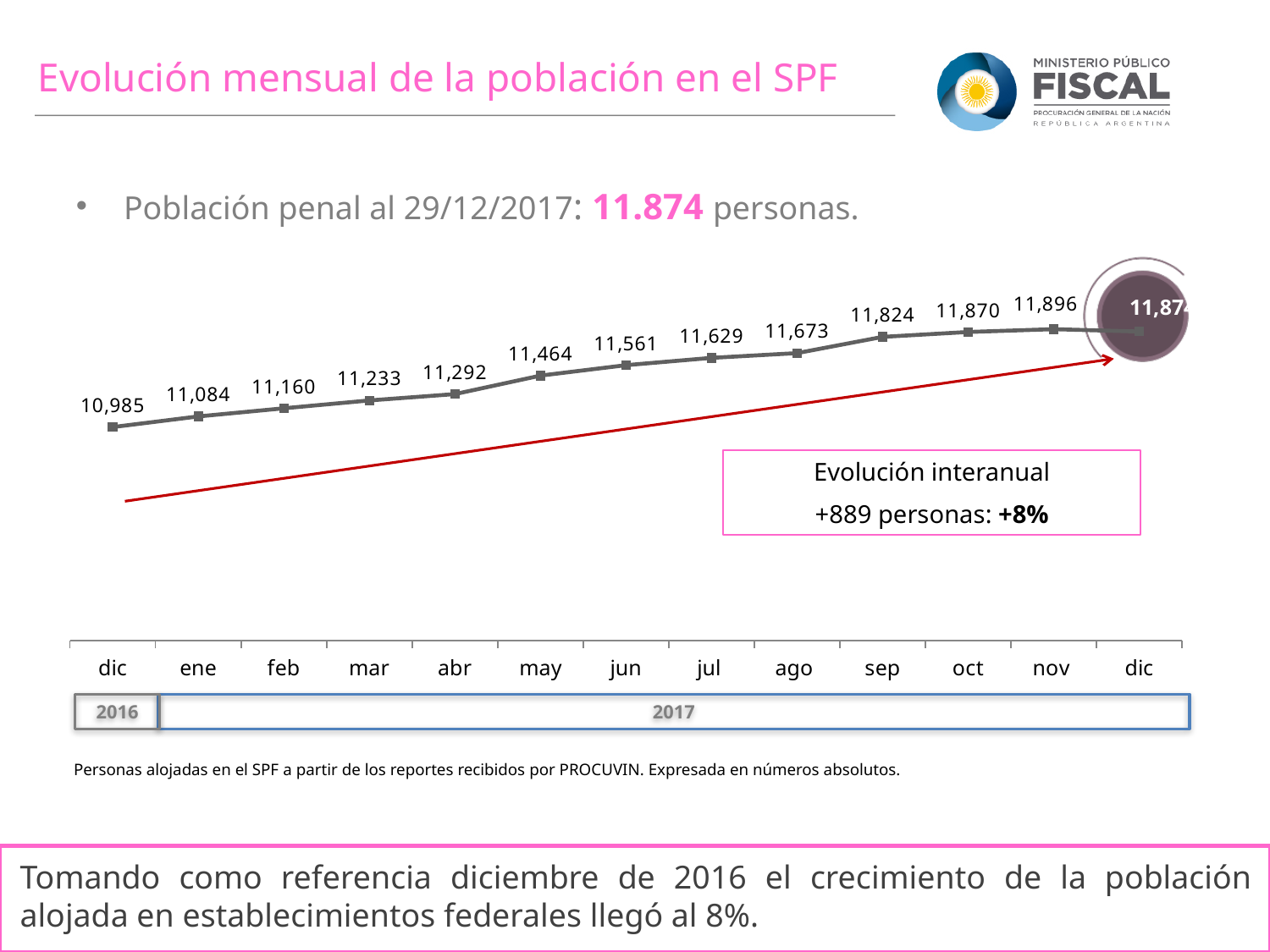
Which month has the highest value? nov 2017 What type of chart is shown on the slide? line chart How many data points are plotted on the chart? 13 What is the value for nov 2017? 11,896 What is the value for sep 2017? 11,824 Do the values generally rise or fall from dic 2016 to nov 2017? rise Which is larger, the value for mar 2017 or the value for abr 2017? abr 2017 What is the difference between the values for jun 2017 and may 2017? 97 What is the value for dic 2016? 10,985 What is the value for may 2017? 11,464 Which month has the lowest value? dic 2016 What is the difference between the values for sep 2017 and ago 2017? 151